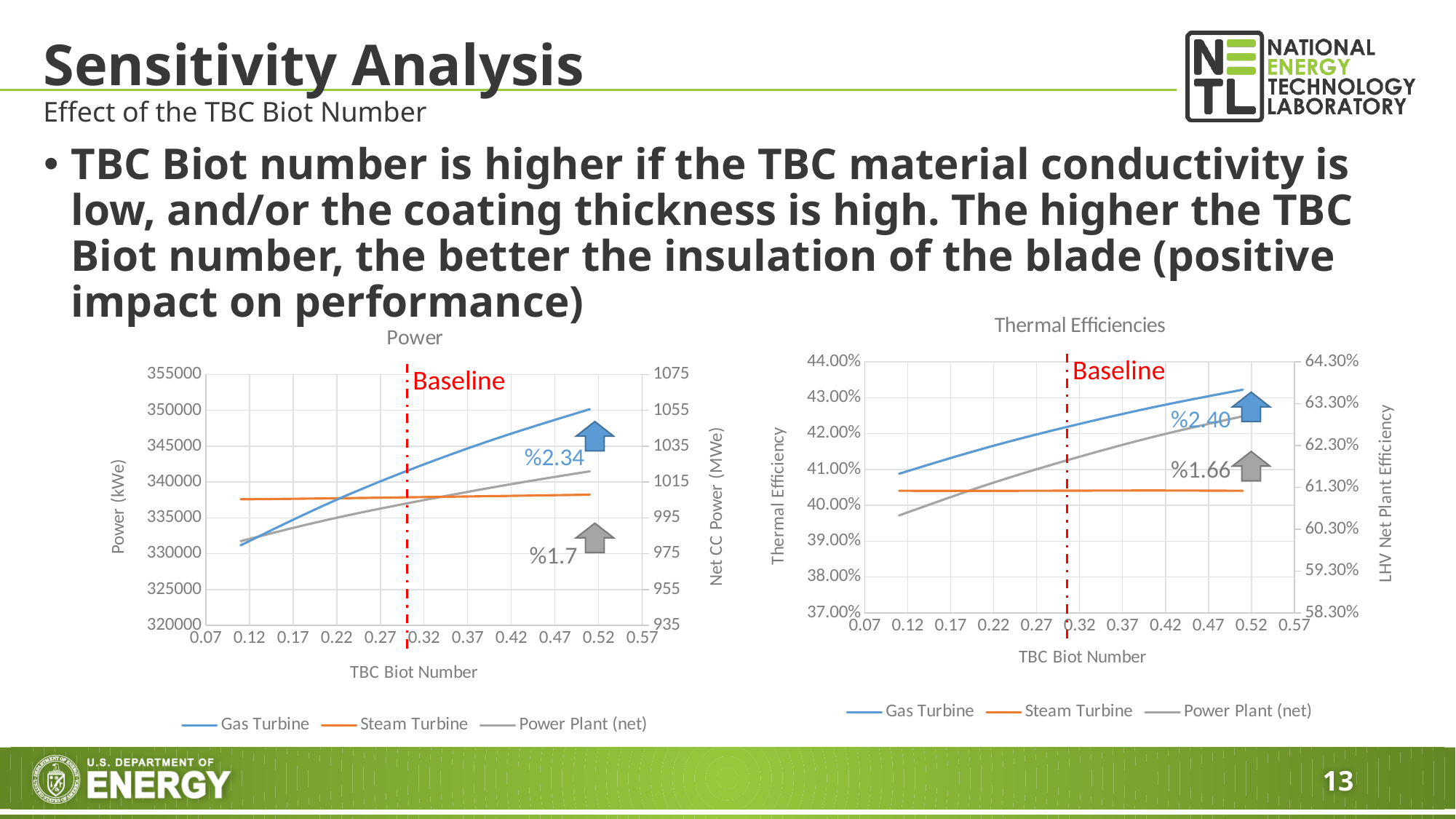
What kind of chart is the "Power" chart on the left? line chart In the "Power" chart, is the Steam Turbine value greater or less than 340000 on the left axis? less How many series does the legend of the "Thermal Efficiencies" chart list? 3 In the "Power" chart, is the Gas Turbine value at a TBC Biot Number of 0.52 greater or less than 345000? greater In the "Power" chart, at a TBC Biot Number of 0.52, which is higher: the Gas Turbine line or the Steam Turbine line? Gas Turbine In the "Thermal Efficiencies" chart, does the Power Plant (net) line rise or fall as the TBC Biot Number increases? rise What is the x-axis title of the "Power" chart? TBC Biot Number In the "Thermal Efficiencies" chart, is the Gas Turbine value at a TBC Biot Number of 0.52 greater or less than 43.00%? greater In the "Power" chart, does the Gas Turbine line rise or fall as the TBC Biot Number increases? rise In the "Thermal Efficiencies" chart, at a TBC Biot Number of 0.12, which is higher: the Gas Turbine line or the Steam Turbine line? Gas Turbine What label is written next to the red dashed vertical line in the "Thermal Efficiencies" chart? Baseline